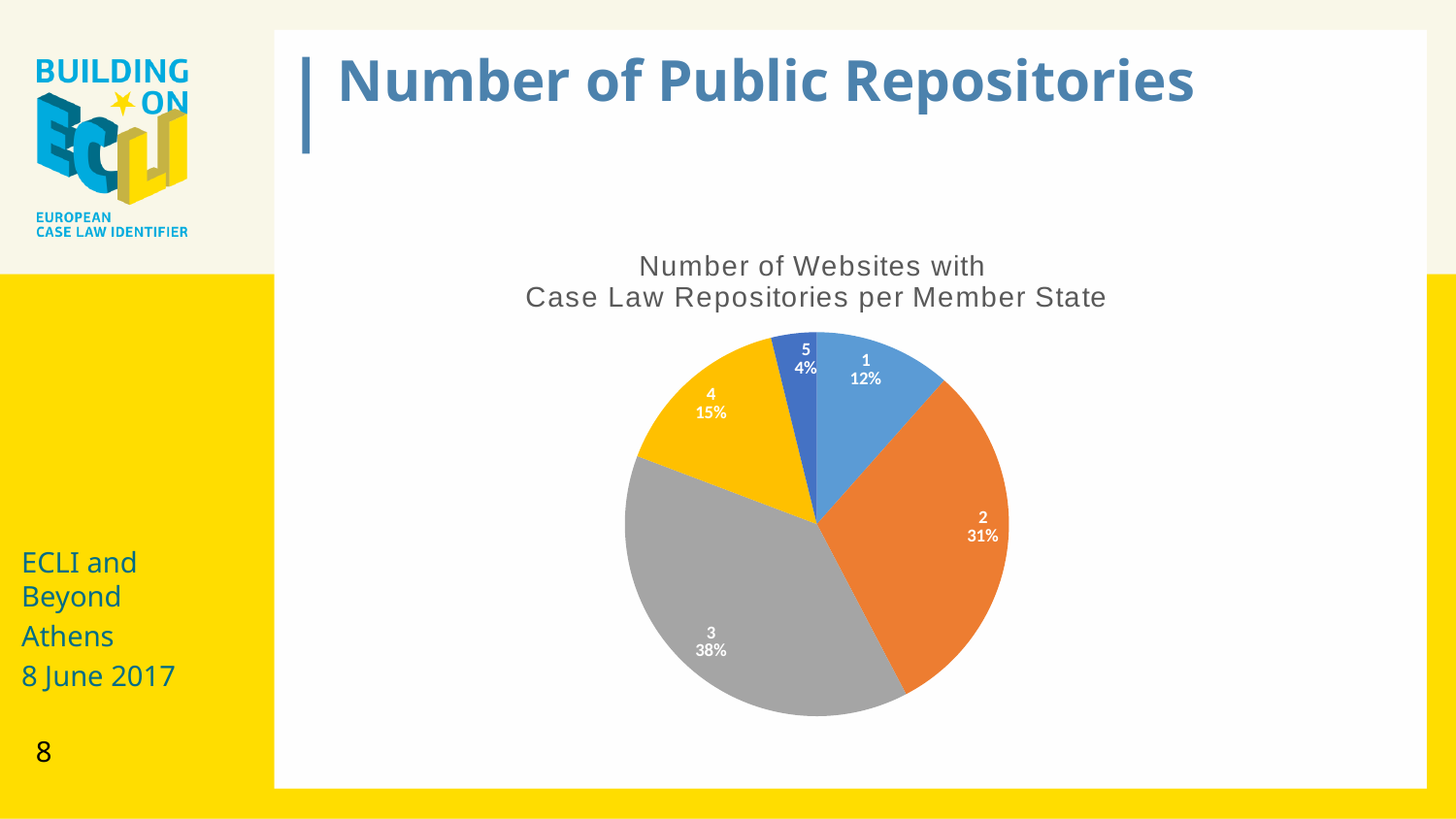
Which category has the largest slice of the pie? 3 Which slice is larger, "4" or "1"? 4 What share of the pie does the category "1" take? 12% What colour is the slice for category "3"? grey What is the title of the chart? Number of Websites with Case Law Repositories per Member State What is the difference in percentage points between the slices for "3" and "2"? 7 How many slices does the pie chart have? 5 What share of the pie does the category "3" take? 38% What share of the pie does the category "2" take? 31% Which category has the smallest slice of the pie? 5 What kind of chart is shown on the slide? pie chart